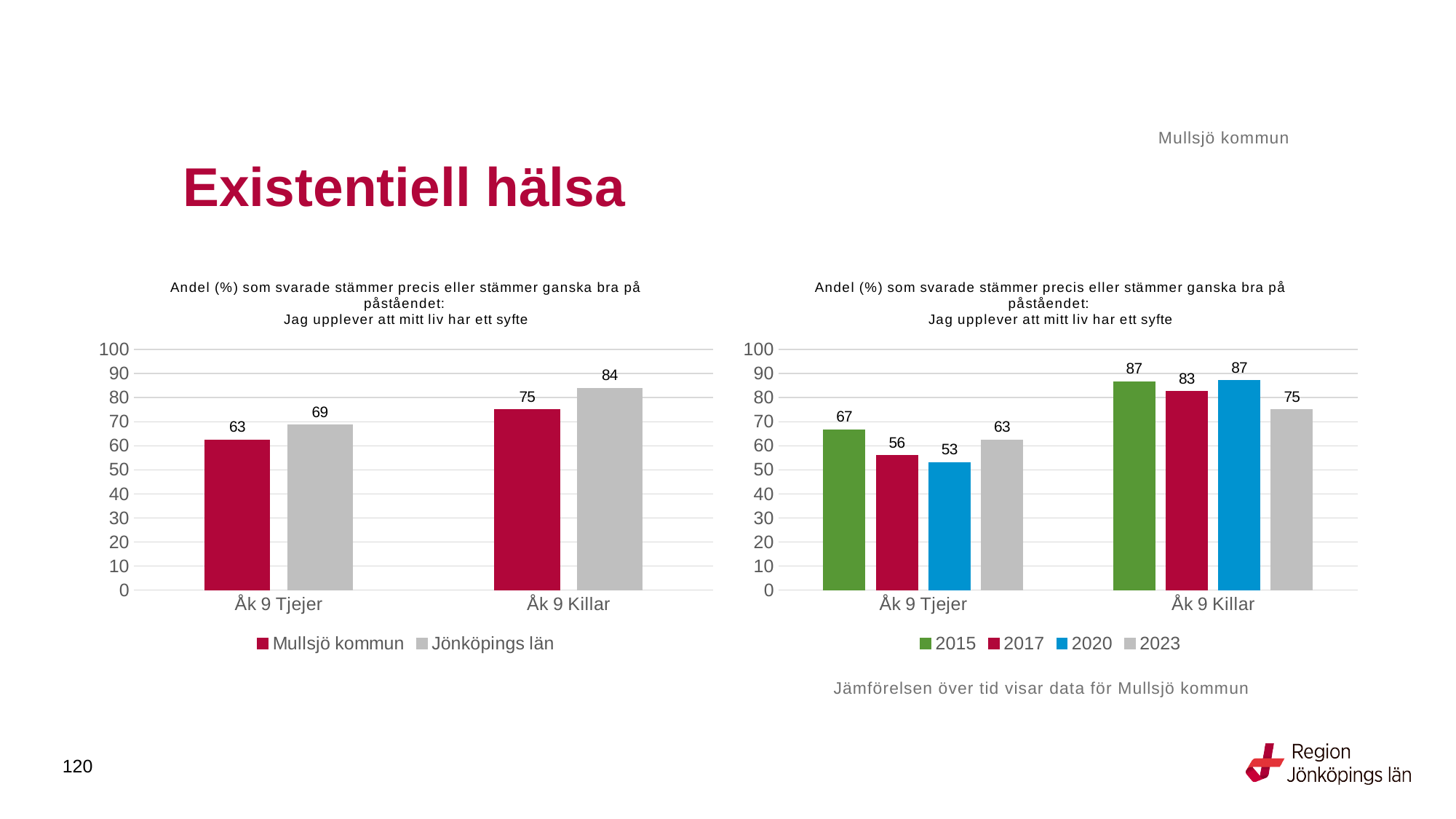
In the right chart, what is the difference between the 2015 and 2017 values for Åk 9 Tjejer? 11 How many series does the legend of the left chart list? 2 In the right chart, what is the value for 2023 for Åk 9 Killar? 75 In the left chart, what is the value for Mullsjö kommun for Åk 9 Tjejer? 63 In the left chart, which is larger for Åk 9 Tjejer: Mullsjö kommun or Jönköpings län? Jönköpings län In the left chart, what is the difference between Jönköpings län and Mullsjö kommun for Åk 9 Killar? 9 In the right chart, is the value for 2017 for Åk 9 Killar greater or less than 80? greater In the left chart, what is the value for Jönköpings län for Åk 9 Killar? 84 How many series does the legend of the right chart list? 4 In the right chart, which year has the lowest value for Åk 9 Tjejer? 2020 In the right chart, what is the value for 2020 for Åk 9 Tjejer? 53 What kind of chart is the right chart? Bar chart